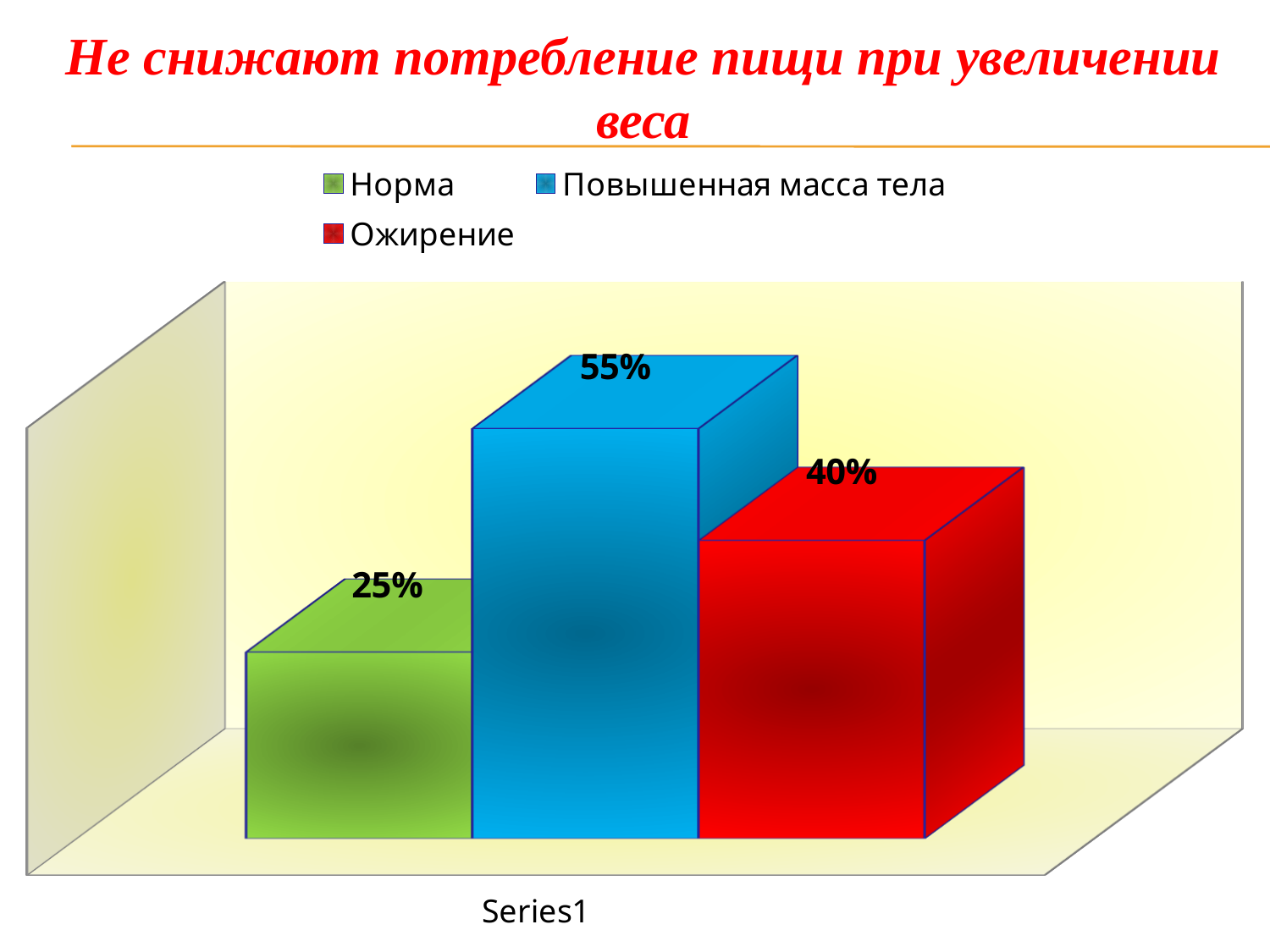
What is the difference between the values for Ожирение and Норма? 15% What is the difference between the values for Повышенная масса тела and Норма? 30% Which is larger, the value for Ожирение or the value for Норма? Ожирение How many series does the legend list? 3 What kind of chart is shown on the slide? Bar chart Which is larger, the value for Повышенная масса тела or the value for Ожирение? Повышенная масса тела What colour is the bar for Ожирение? Red Which series has the lowest value? Норма What is the value for Повышенная масса тела? 55% What is the value for Ожирение? 40% Which series has the highest value? Повышенная масса тела What is the value for Норма? 25%